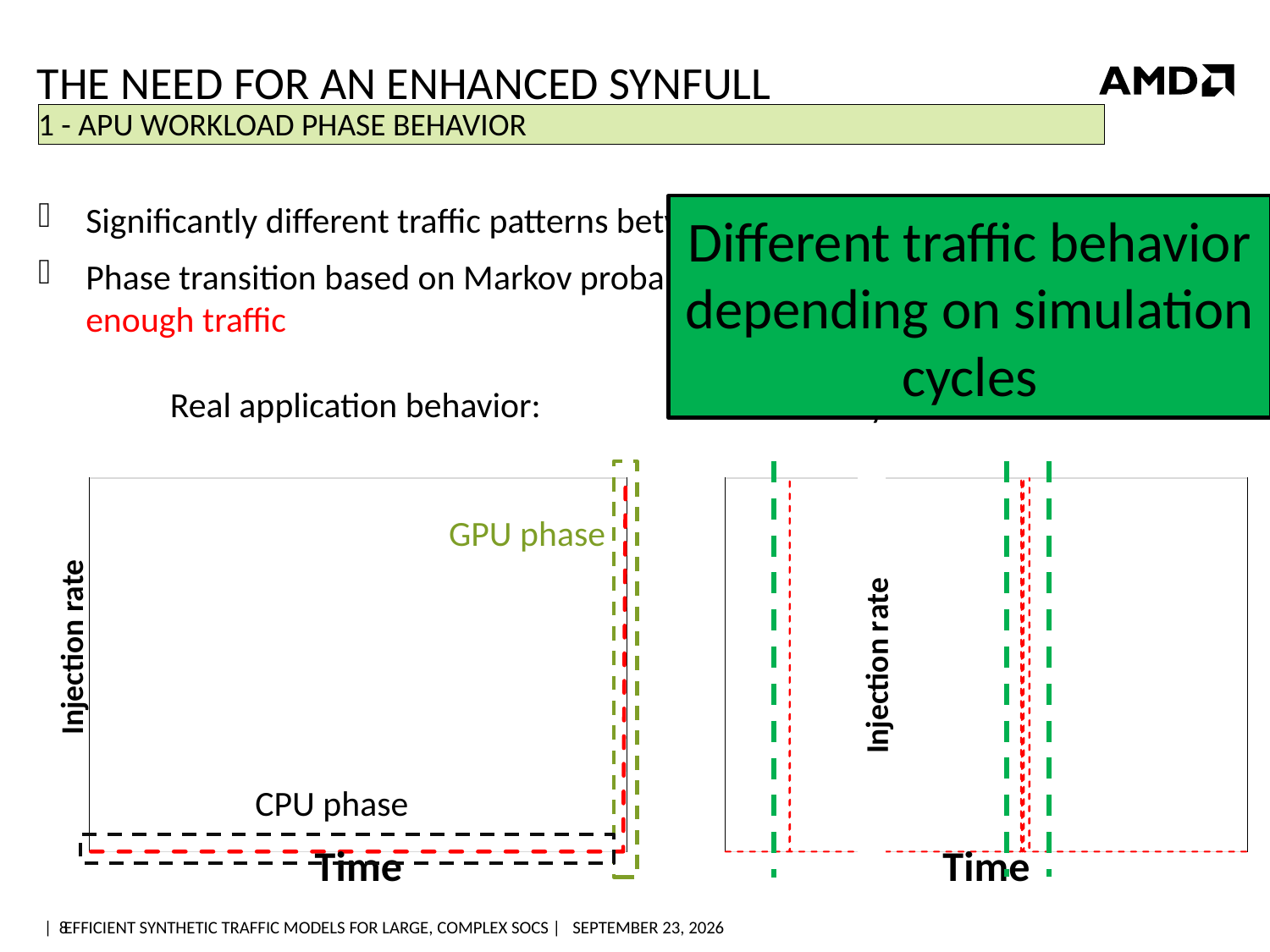
On the left chart, which phase shows the higher injection rate, the CPU phase or the GPU phase? GPU phase On the left chart, which phase is labeled next to the tall spike at the right? GPU phase On the left chart, what is the label of the y axis? Injection rate What kind of chart is the left chart labeled 'Real application behavior'? line chart On the left chart, which phase is labeled along the low flat part of the line? CPU phase How many phases are labeled on the left chart? 2 On the left chart, does the injection rate rise or fall at the right end of the time axis? rises On the left chart, what is the label of the x axis? Time